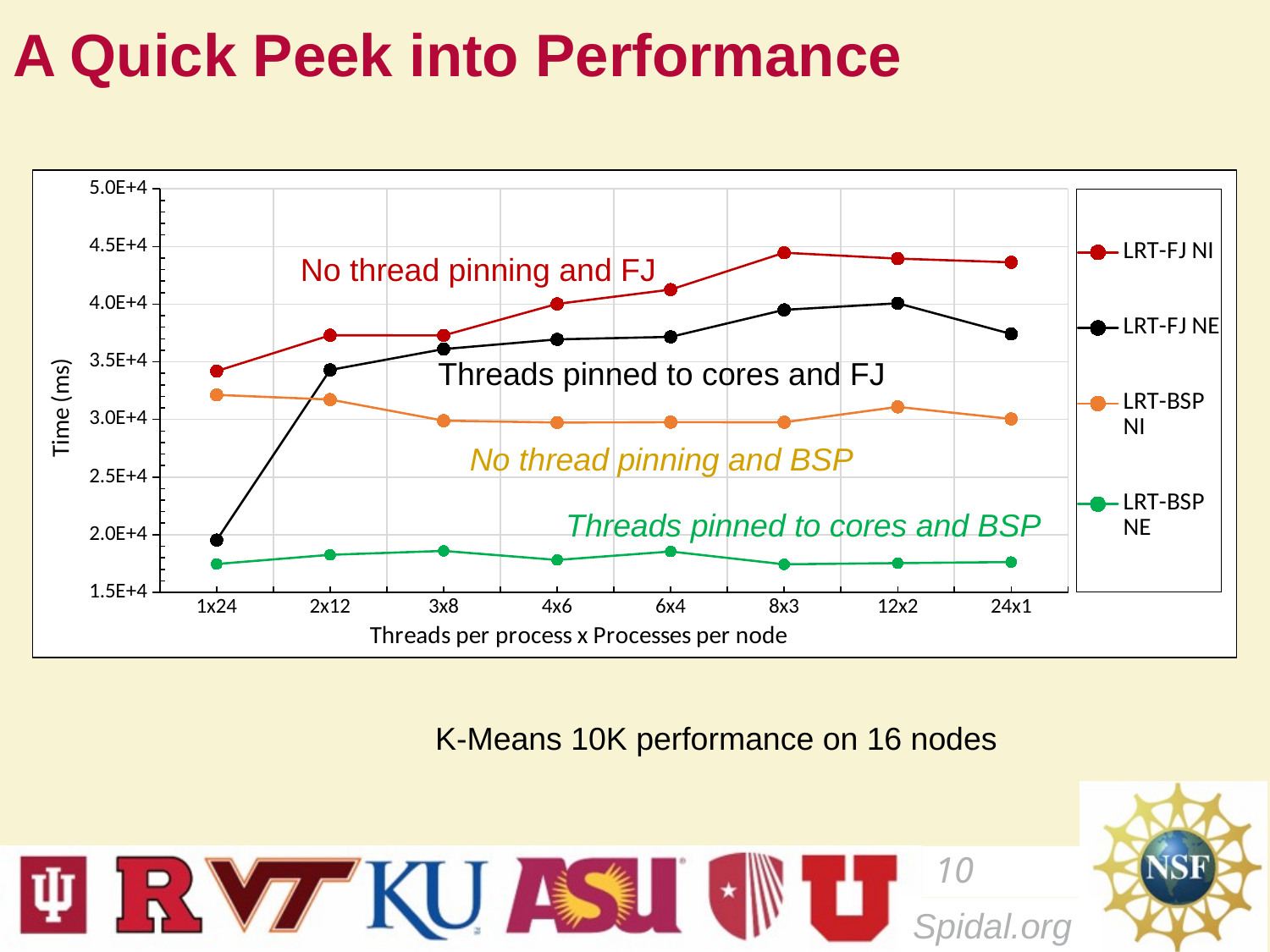
How many series does the legend list? 4 Is the value for LRT-BSP NI at 1x24 greater or less than 3.0E+4? greater What is the title of the y axis? Time (ms) Does the LRT-FJ NI series rise or fall from 1x24 to 8x3? rise What kind of chart is shown on the slide? line chart Is the value for LRT-BSP NE at 1x24 greater or less than 2.0E+4? less Which series has the lowest values across the chart? LRT-BSP NE How many categories are shown on the x axis? 8 Which series has the highest value at 8x3? LRT-FJ NI What is the title of the x axis? Threads per process x Processes per node At 1x24, which is larger: LRT-FJ NI or LRT-FJ NE? LRT-FJ NI Is the value for LRT-FJ NI at 8x3 greater or less than 4.0E+4? greater